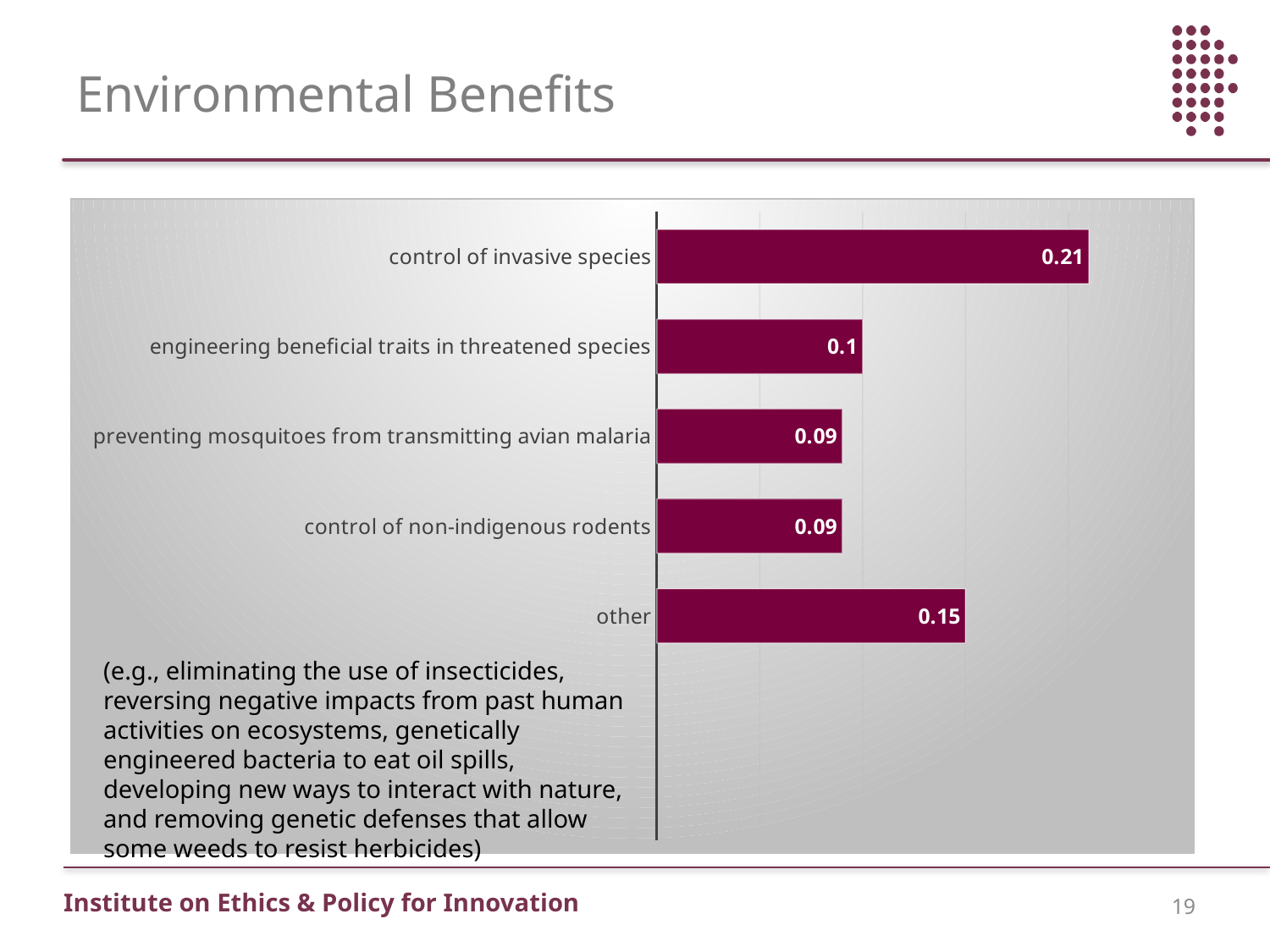
What is the difference between the values for engineering beneficial traits in threatened species and control of non-indigenous rodents? 0.01 What is the title of the slide containing the chart? Environmental Benefits Which two categories share the same value of 0.09? preventing mosquitoes from transmitting avian malaria and control of non-indigenous rodents What is the value for control of invasive species? 0.21 Which category has the highest value? control of invasive species Which is larger, the value for other or the value for engineering beneficial traits in threatened species? other What is the value for engineering beneficial traits in threatened species? 0.1 What is the value for other? 0.15 How many categories are shown in the chart? 5 What kind of chart is shown on the slide? bar chart What is the value for preventing mosquitoes from transmitting avian malaria? 0.09 What is the difference between the values for control of invasive species and other? 0.06